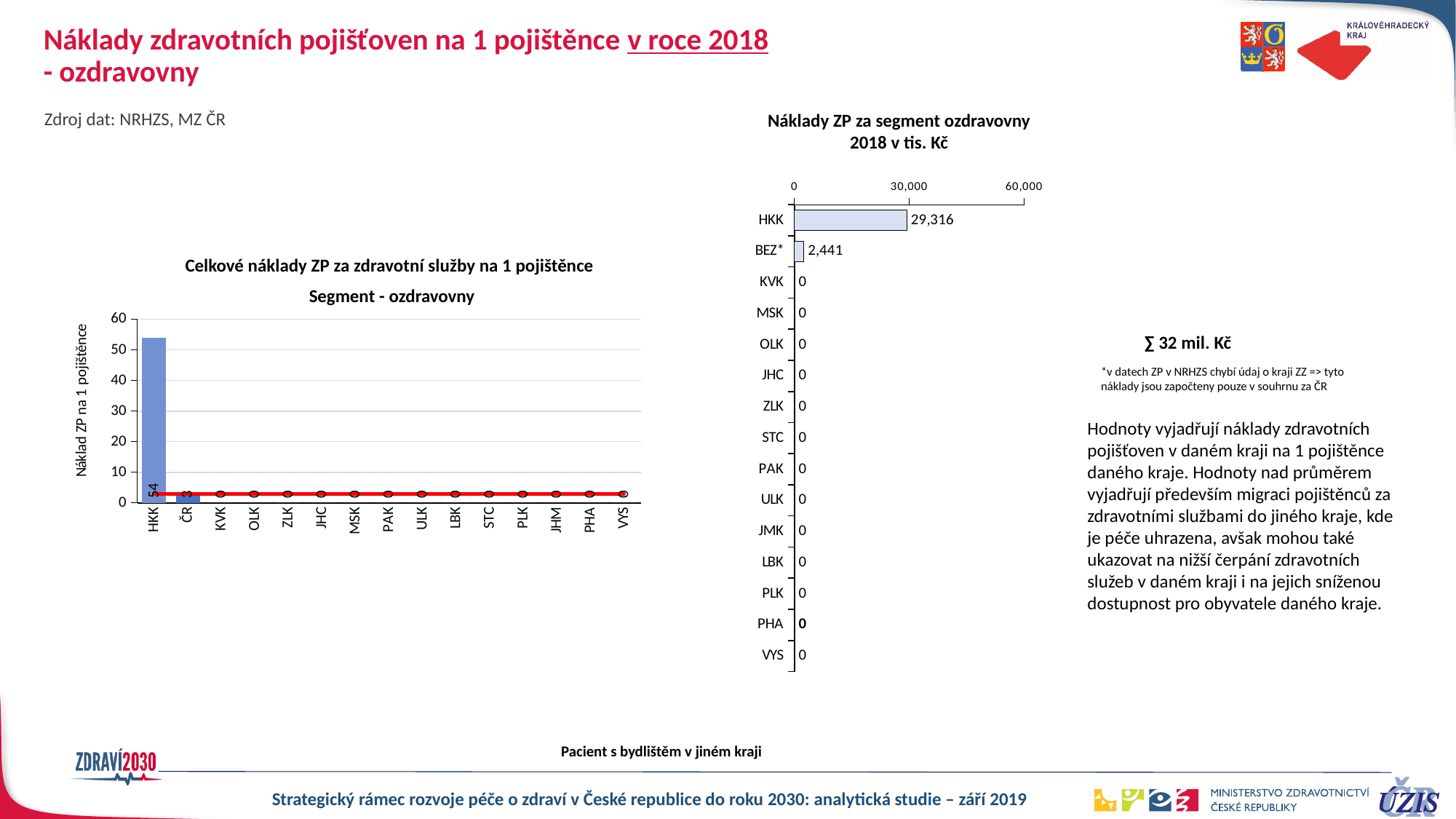
In the chart titled 'Náklady ZP za segment ozdravovny 2018 v tis. Kč', what is the value for KVK? 0 In the chart titled 'Celkové náklady ZP za zdravotní služby na 1 pojištěnce', which category has the highest value? HKK In the chart titled 'Náklady ZP za segment ozdravovny 2018 v tis. Kč', is the value for HKK greater or less than 30,000? less How many categories are shown on the x axis of the chart titled 'Celkové náklady ZP za zdravotní služby na 1 pojištěnce'? 15 What kind of chart is the one titled 'Náklady ZP za segment ozdravovny 2018 v tis. Kč'? bar chart In the chart titled 'Náklady ZP za segment ozdravovny 2018 v tis. Kč', what is the value for HKK? 29,316 In the chart titled 'Náklady ZP za segment ozdravovny 2018 v tis. Kč', what is the difference between the values for HKK and BEZ*? 26,875 In the chart titled 'Celkové náklady ZP za zdravotní služby na 1 pojištěnce', is the value for HKK greater or less than 50? greater In the chart titled 'Náklady ZP za segment ozdravovny 2018 v tis. Kč', which category has the highest value? HKK In the chart titled 'Náklady ZP za segment ozdravovny 2018 v tis. Kč', what is the value for BEZ*? 2,441 In the chart titled 'Celkové náklady ZP za zdravotní služby na 1 pojištěnce', what is the value for HKK? 54 How many categories are shown in the chart titled 'Náklady ZP za segment ozdravovny 2018 v tis. Kč'? 15